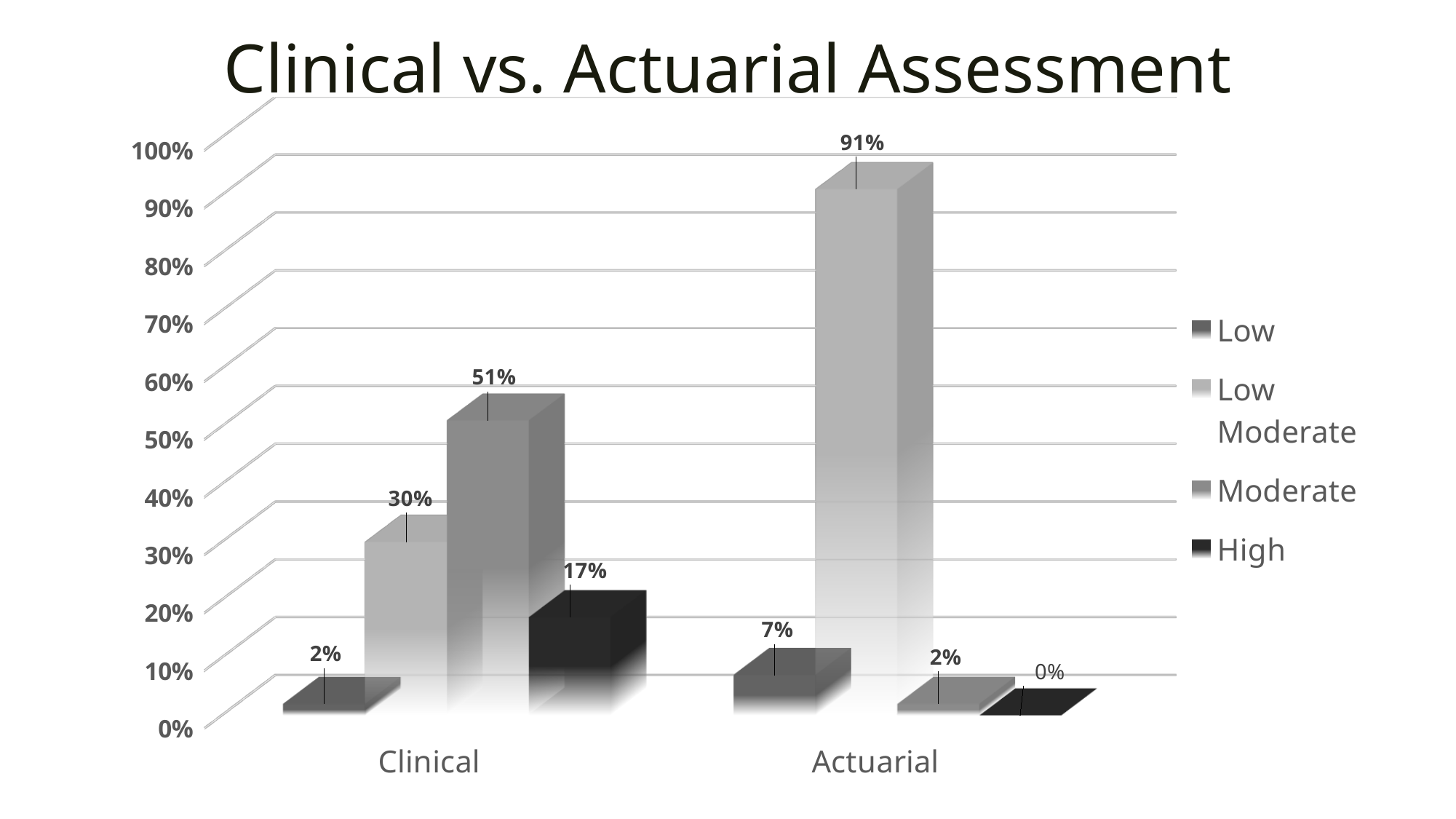
Which series has the lowest value in the Clinical category? Low What is the value for Moderate in the Clinical category? 51% Which series has the highest value in the Actuarial category? Low Moderate What is the title of the chart? Clinical vs. Actuarial Assessment How many categories are shown on the x axis? 2 How many series does the legend list? 4 What is the value for Low in the Actuarial category? 7% Which is larger: the Low Moderate value for Clinical or the Low Moderate value for Actuarial? Actuarial What is the value for Low Moderate in the Actuarial category? 91% What kind of chart is shown on the slide? Bar chart What is the value for High in the Clinical category? 17% What is the difference between the Moderate value for Clinical and the Moderate value for Actuarial? 49%